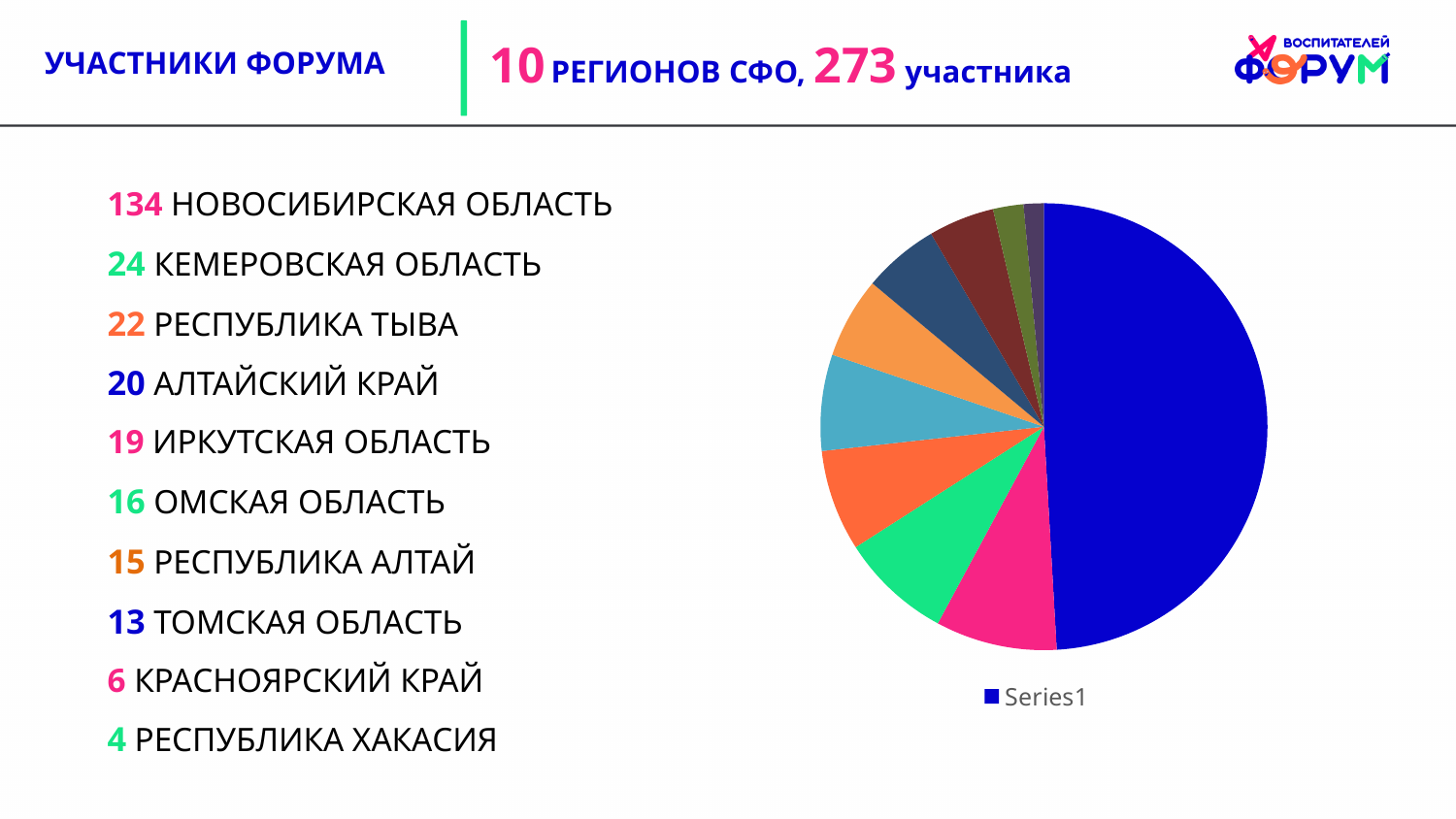
How many participants are from Республика Тыва? 22 Which region has the largest number of forum participants? Новосибирская область How many slices does the pie chart have? 10 What is the difference in participants between Новосибирская область and Кемеровская область? 110 Which region has the smallest number of forum participants? Республика Хакасия How many participants are from Кемеровская область? 24 What is the total number of forum participants across all regions? 273 How many participants are from Томская область? 13 What kind of chart is shown on the slide? pie chart How many series does the chart legend list? 1 Which has more participants, Омская область or Республика Алтай? Омская область What is the legend entry shown below the pie chart? Series1